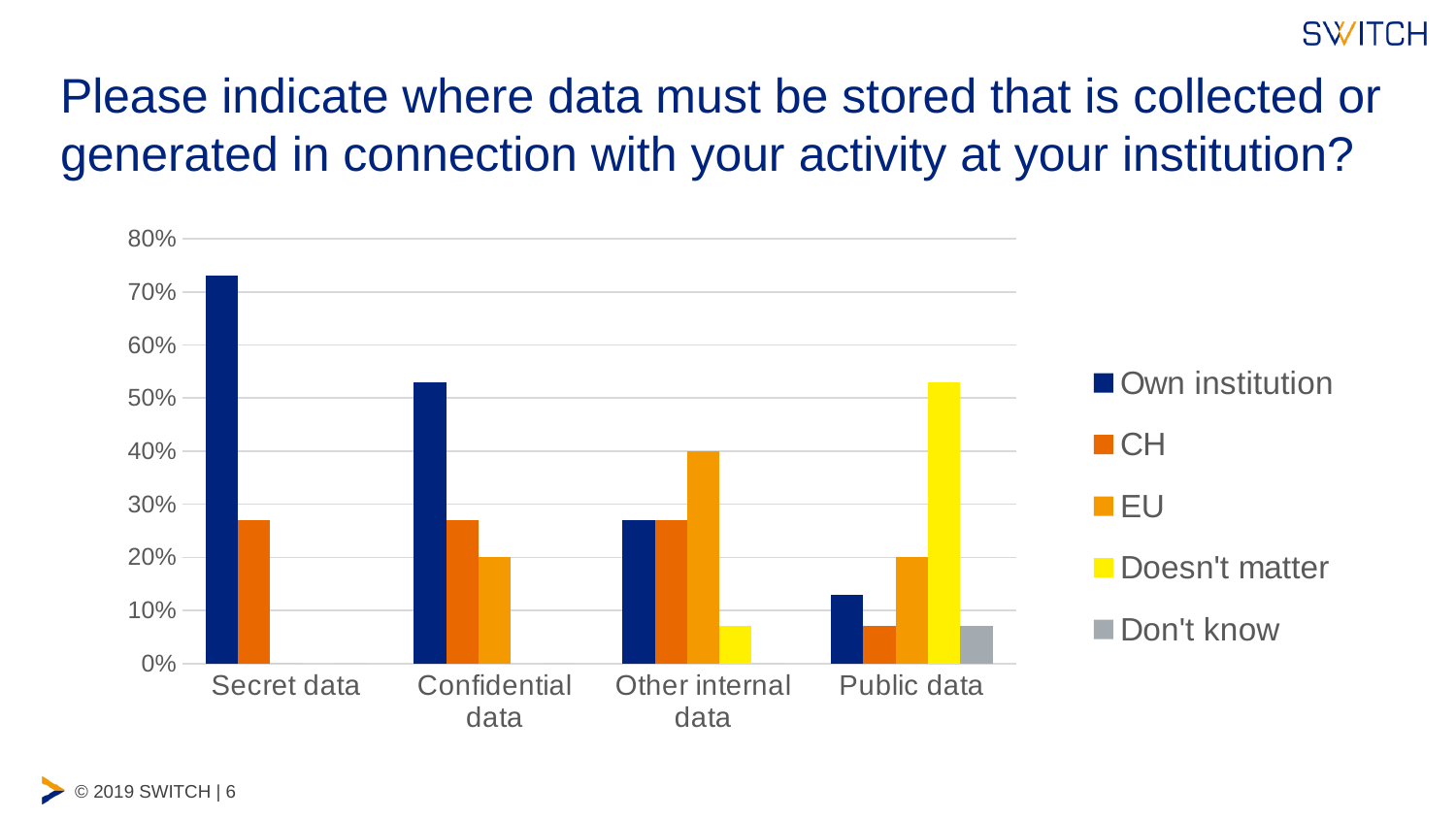
Do the Own institution values rise or fall from Secret data to Public data along the x axis? fall Is the Doesn't matter value for Public data greater or less than 50%? greater Is the Own institution value for Secret data greater or less than 70%? greater Is the EU value for Other internal data greater or less than 30%? greater How many series does the legend list? 5 For which data category is the Own institution bar highest? Secret data How many data categories are shown on the x axis? 4 For Public data, which is larger: the Doesn't matter value or the EU value? Doesn't matter For Other internal data, which is larger: the EU value or the Own institution value? EU For which data category is the Own institution bar lowest? Public data What kind of chart is shown on the slide? bar chart